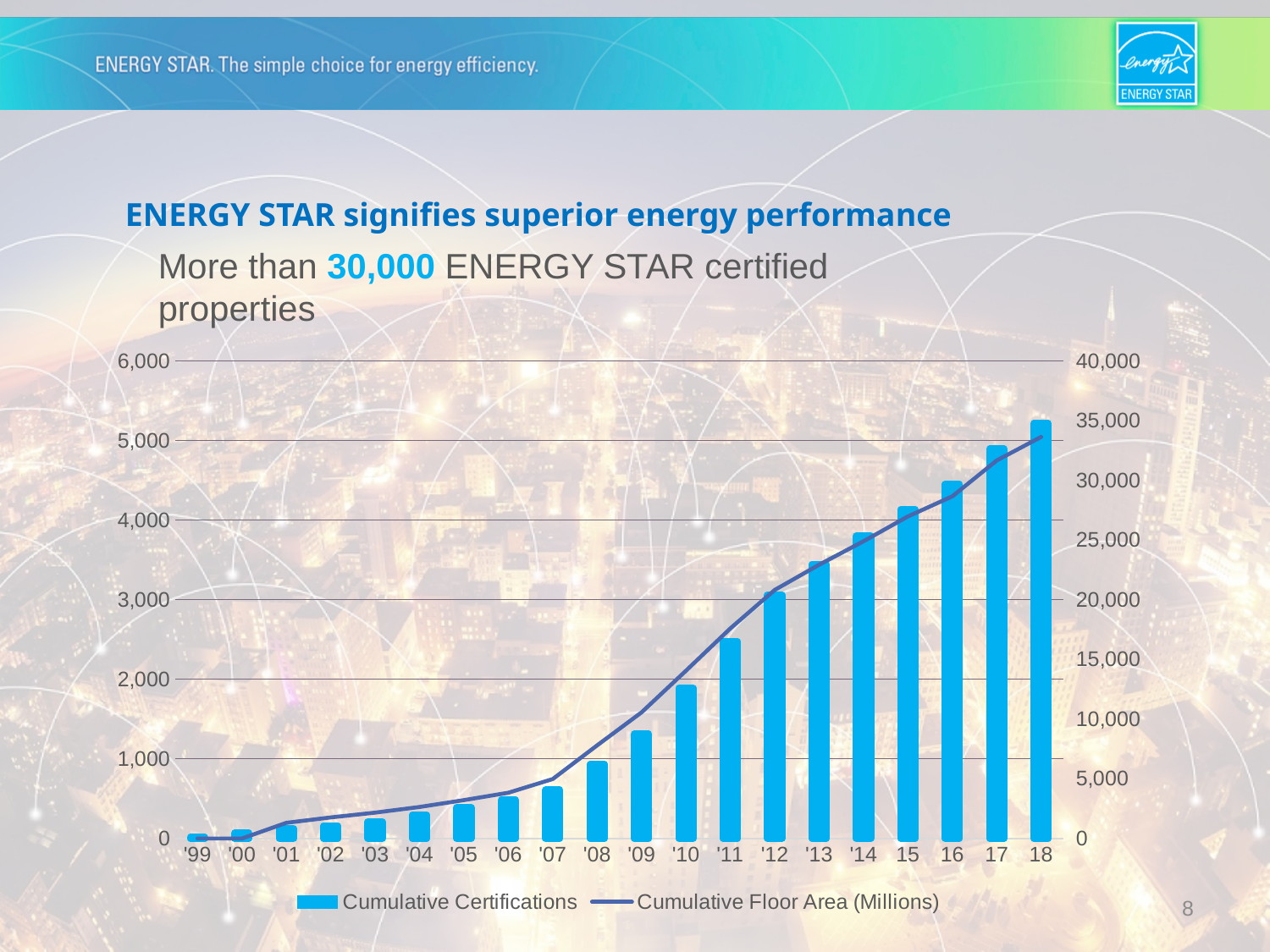
Which year has the highest Cumulative Certifications bar? 18 How many years (categories) are plotted along the x axis? 20 Which series is shown as bars in the chart? Cumulative Certifications How many series does the chart legend list? 2 Is the Cumulative Floor Area (Millions) value for '14 greater or less than 3,000? greater Is the Cumulative Certifications value for '10 greater or less than 10,000? greater Is the Cumulative Certifications value for '08 greater or less than 10,000? less Which series is shown as a line in the chart? Cumulative Floor Area (Millions) What kind of chart is shown on the slide? A combination bar and line chart Do the Cumulative Certifications values rise or fall from '99 to 18? Rise Which year has the lowest Cumulative Certifications bar? '99